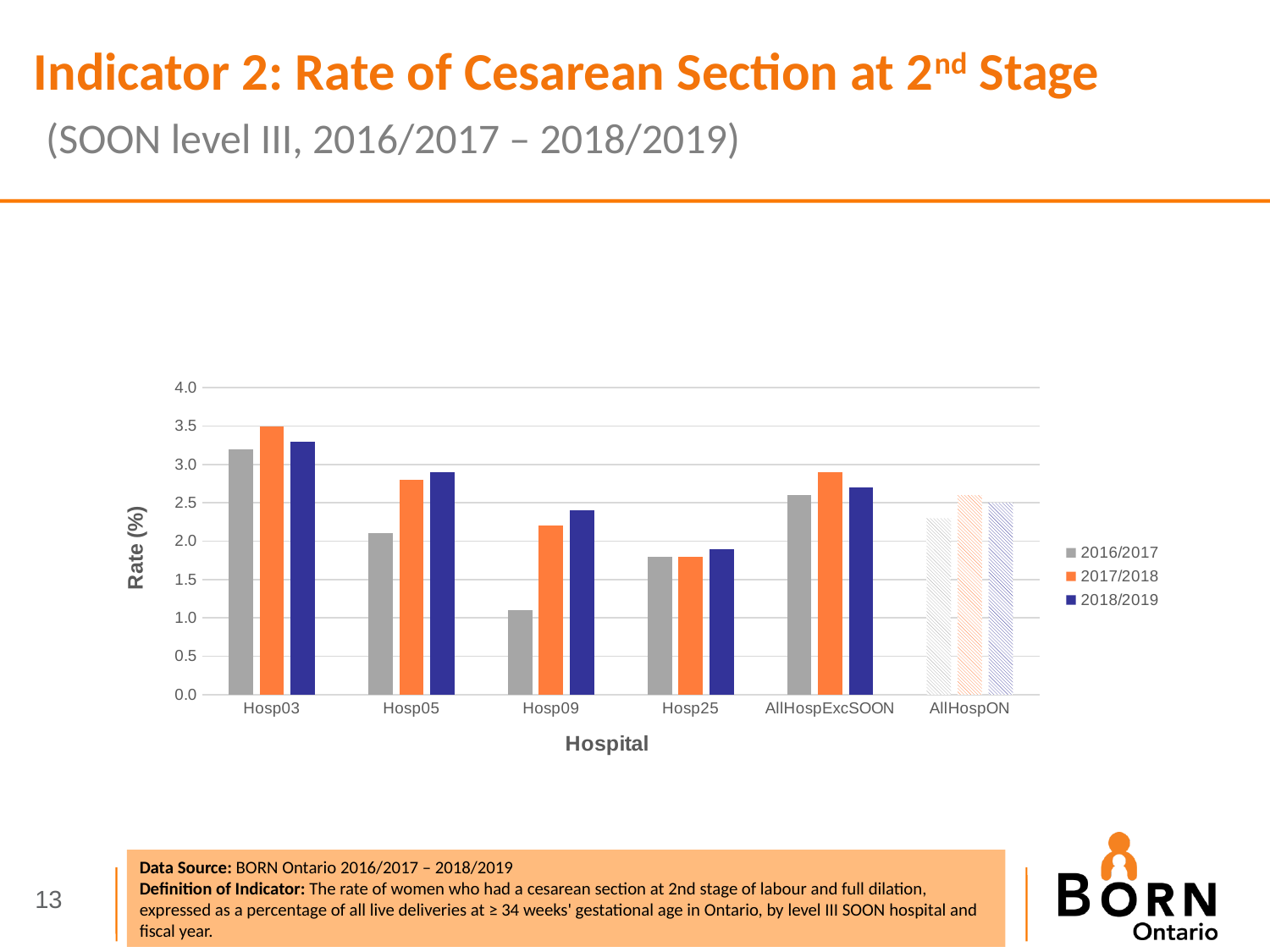
Which hospital category has the highest 2017/2018 bar? Hosp03 What is the label of the y axis? Rate (%) Do the values for Hosp09 rise or fall from 2016/2017 to 2018/2019? rise Is the 2016/2017 value for Hosp03 greater or less than 3.0? greater How many series does the legend list? 3 How many hospital categories are shown on the x axis? 6 Which hospital category has the lowest 2016/2017 bar? Hosp09 For Hosp05, which is larger: the 2016/2017 value or the 2018/2019 value? 2018/2019 Is the 2017/2018 value for AllHospExcSOON greater or less than 2.5? greater Is the 2016/2017 value for Hosp09 greater or less than 1.5? less What kind of chart is shown on the slide? bar chart